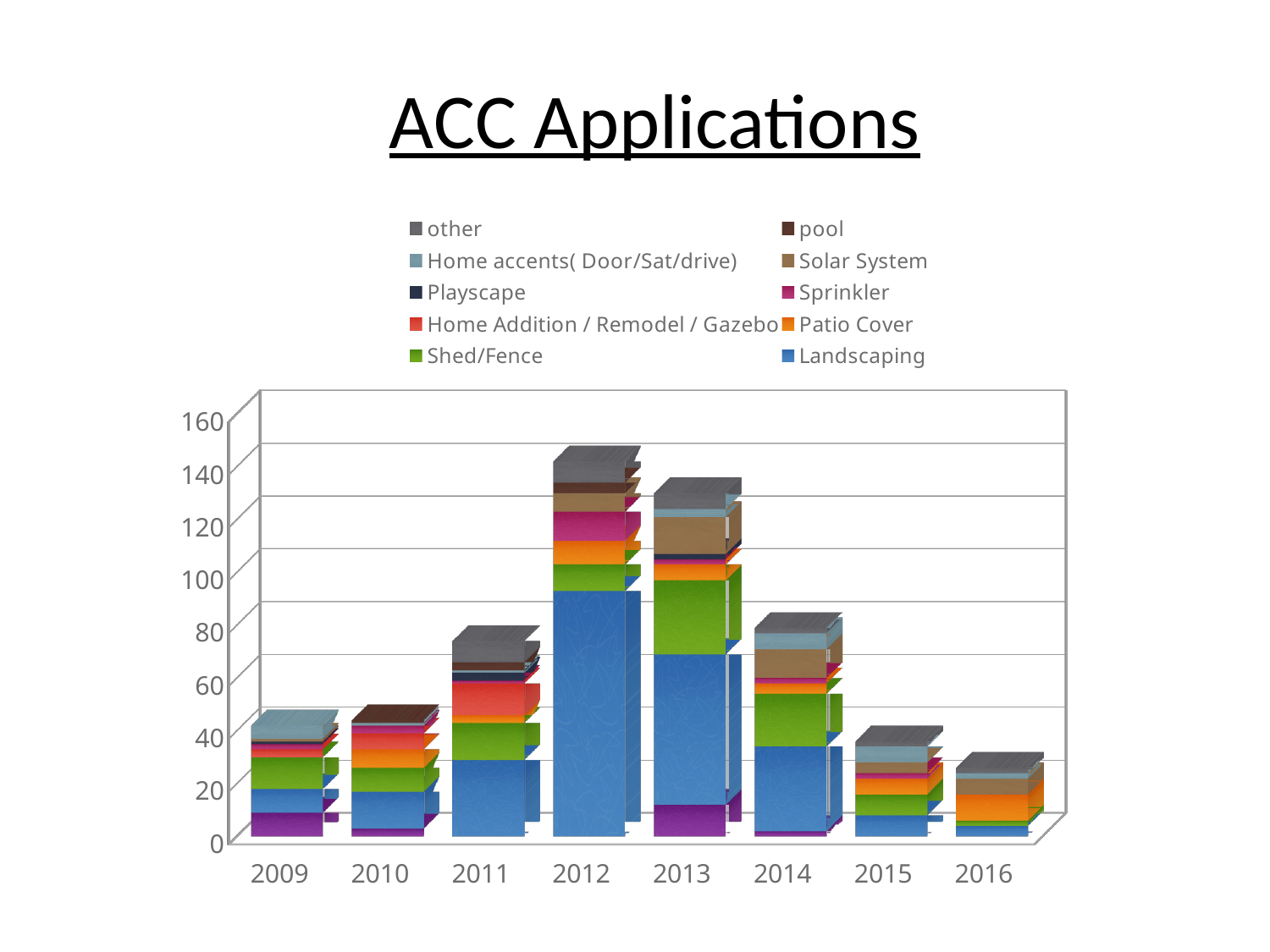
Do the totals rise or fall from 2012 to 2016? fall How many years are shown along the x axis of the chart? 8 Is the total for 2009 greater or less than 60? less Which year has the lowest total of ACC applications? 2016 Which year has the larger total, 2010 or 2011? 2011 What is the title of the chart? ACC Applications Is the total for 2012 greater or less than 120? greater Which series is shown in blue at the bottom of the stacked bars? Landscaping Which year has the highest total of ACC applications? 2012 How many series does the legend list? 10 Is the total for 2013 greater or less than 100? greater What kind of chart is shown on the slide? Stacked bar chart